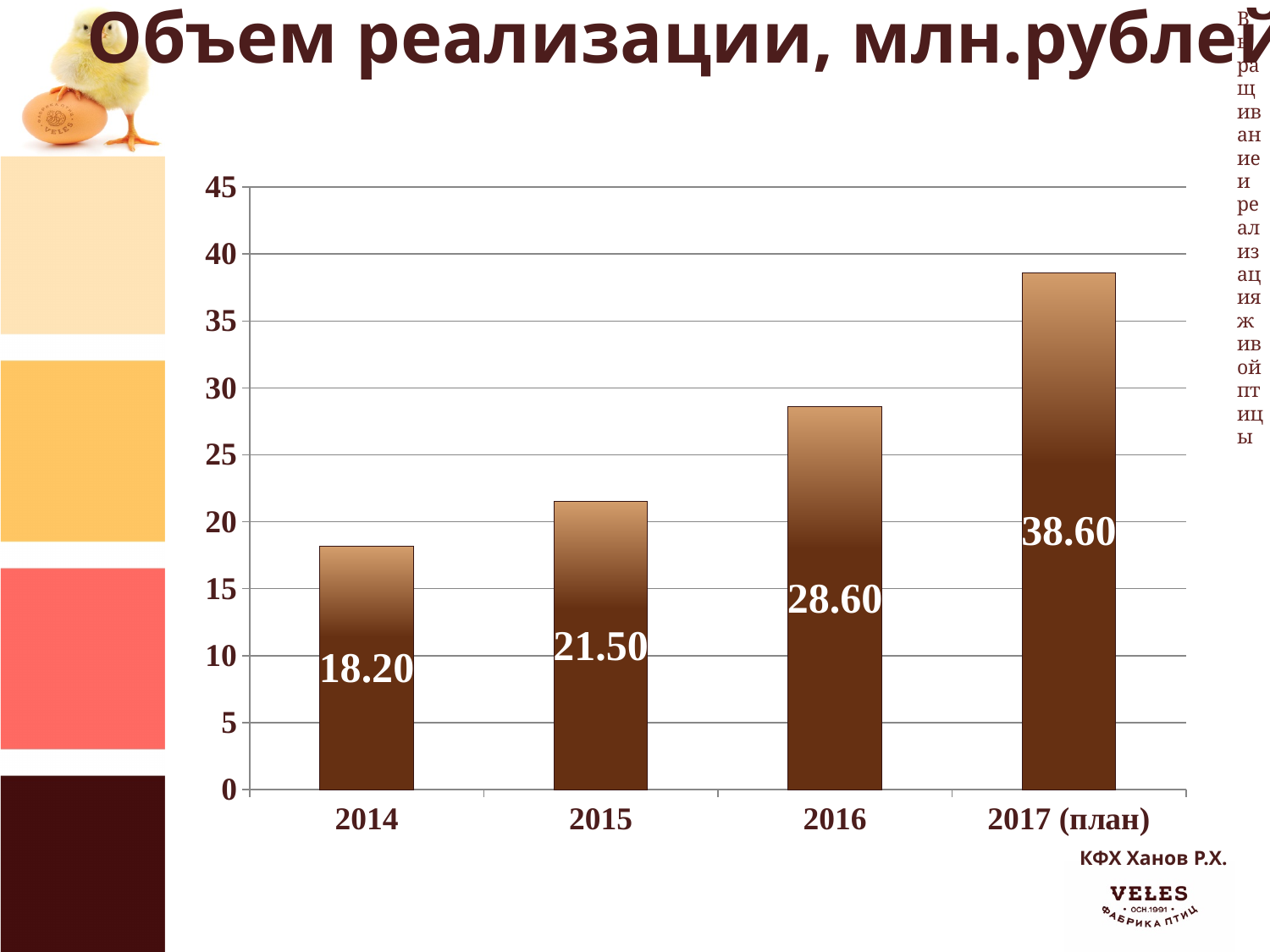
How many categories are shown on the x axis? 4 What is the value for 2014? 18.20 What is the difference between the values for 2017 (план) and 2016? 10.00 What kind of chart is shown on the slide? bar chart What is the value for 2015? 21.50 What is the difference between the values for 2015 and 2014? 3.30 Which category has the lowest value? 2014 Is the value for 2017 (план) greater or less than 35? greater What is the value for 2017 (план)? 38.60 Which category has the highest value? 2017 (план) What is the value for 2016? 28.60 Which is larger, the value for 2016 or the value for 2015? 2016